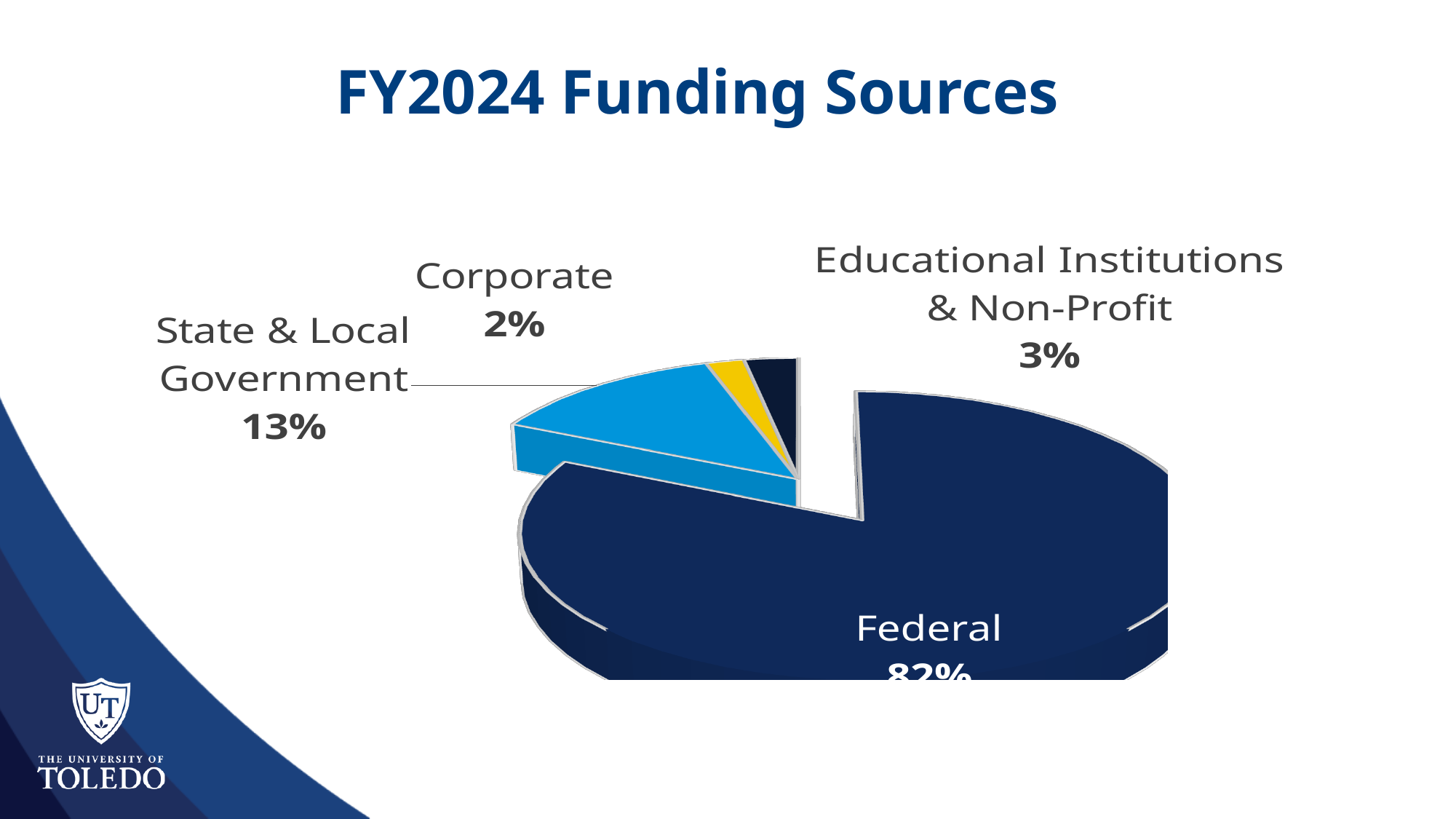
What is the difference in percentage points between the State & Local Government share and the Corporate share? 11 percentage points What share of funding comes from Corporate sources? 2% What kind of chart is shown on the slide? pie chart What is the title of the chart? FY2024 Funding Sources How many slices does the pie chart have? 4 What share of funding comes from State & Local Government? 13% What share of funding comes from Federal sources? 82% What colour is the Corporate slice? yellow Which is larger, the share for State & Local Government or the share for Educational Institutions & Non-Profit? State & Local Government Which funding source has the smallest share? Corporate Which funding source has the largest share? Federal